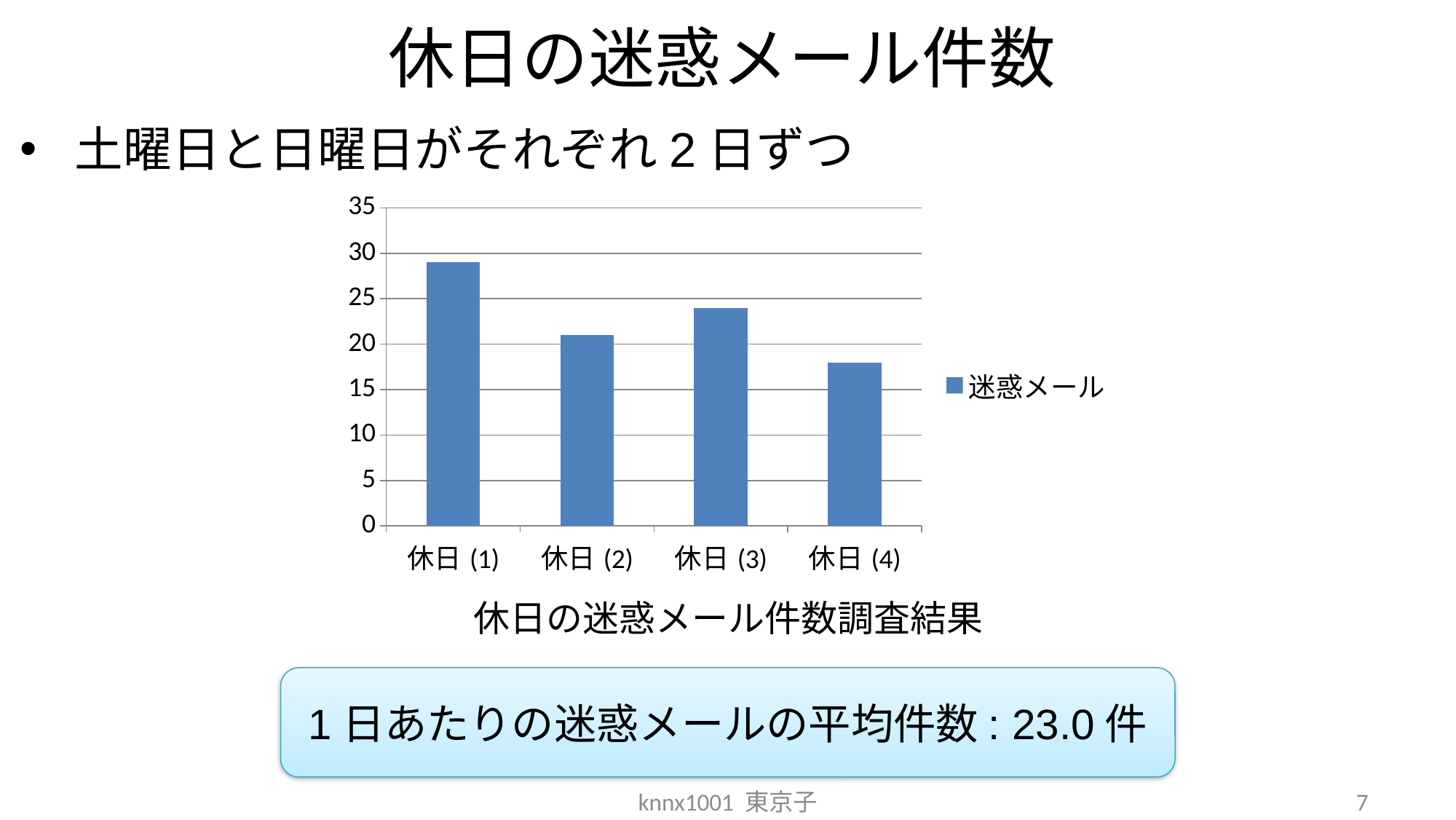
Is the value for 休日 (1) greater or less than 25? greater Is the value for 休日 (2) greater or less than 25? less Which category has the lowest value in the chart? 休日 (4) Is the value for 休日 (4) greater or less than 20? less How many series does the chart's legend list? 1 Which category has the highest value in the chart? 休日 (1) How many categories are plotted on the x axis of the chart? 4 Which is larger, the value for 休日 (3) or the value for 休日 (4)? 休日 (3) What kind of chart is shown on the slide? bar chart Which is larger, the value for 休日 (2) or the value for 休日 (3)? 休日 (3) What is the name of the series shown in the chart's legend? 迷惑メール